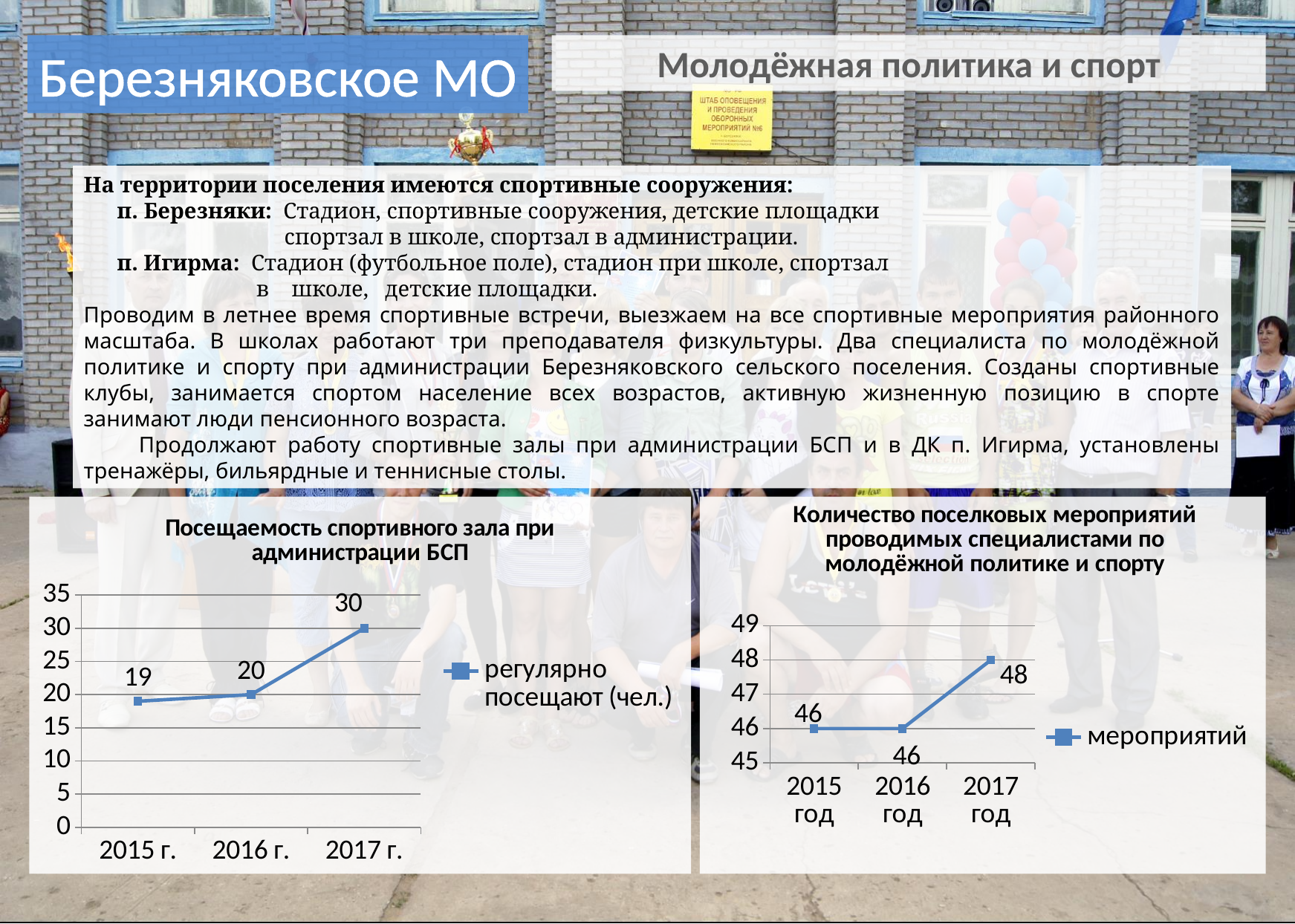
In the left chart 'Посещаемость спортивного зала при администрации БСП', which year has the highest value? 2017 г. In the right chart 'Количество поселковых мероприятий проводимых специалистами по молодёжной политике и спорту', how many years are plotted? 3 In the left chart 'Посещаемость спортивного зала при администрации БСП', what is the difference between the 2017 г. and 2016 г. values? 10 In the left chart 'Посещаемость спортивного зала при администрации БСП', what is the value for 2015 г.? 19 In the left chart 'Посещаемость спортивного зала при администрации БСП', do the values rise or fall from 2015 г. to 2017 г.? rise In the left chart 'Посещаемость спортивного зала при администрации БСП', what is the legend entry? регулярно посещают (чел.) In the right chart 'Количество поселковых мероприятий проводимых специалистами по молодёжной политике и спорту', what is the value for 2017 год? 48 In the left chart 'Посещаемость спортивного зала при администрации БСП', what is the value for 2017 г.? 30 In the right chart 'Количество поселковых мероприятий проводимых специалистами по молодёжной политике и спорту', what is the value for 2015 год? 46 In the right chart 'Количество поселковых мероприятий проводимых специалистами по молодёжной политике и спорту', what is the difference between the 2017 год and 2016 год values? 2 What kind of chart is the left chart 'Посещаемость спортивного зала при администрации БСП'? line chart In the right chart 'Количество поселковых мероприятий проводимых специалистами по молодёжной политике и спорту', how many series does the legend list? 1